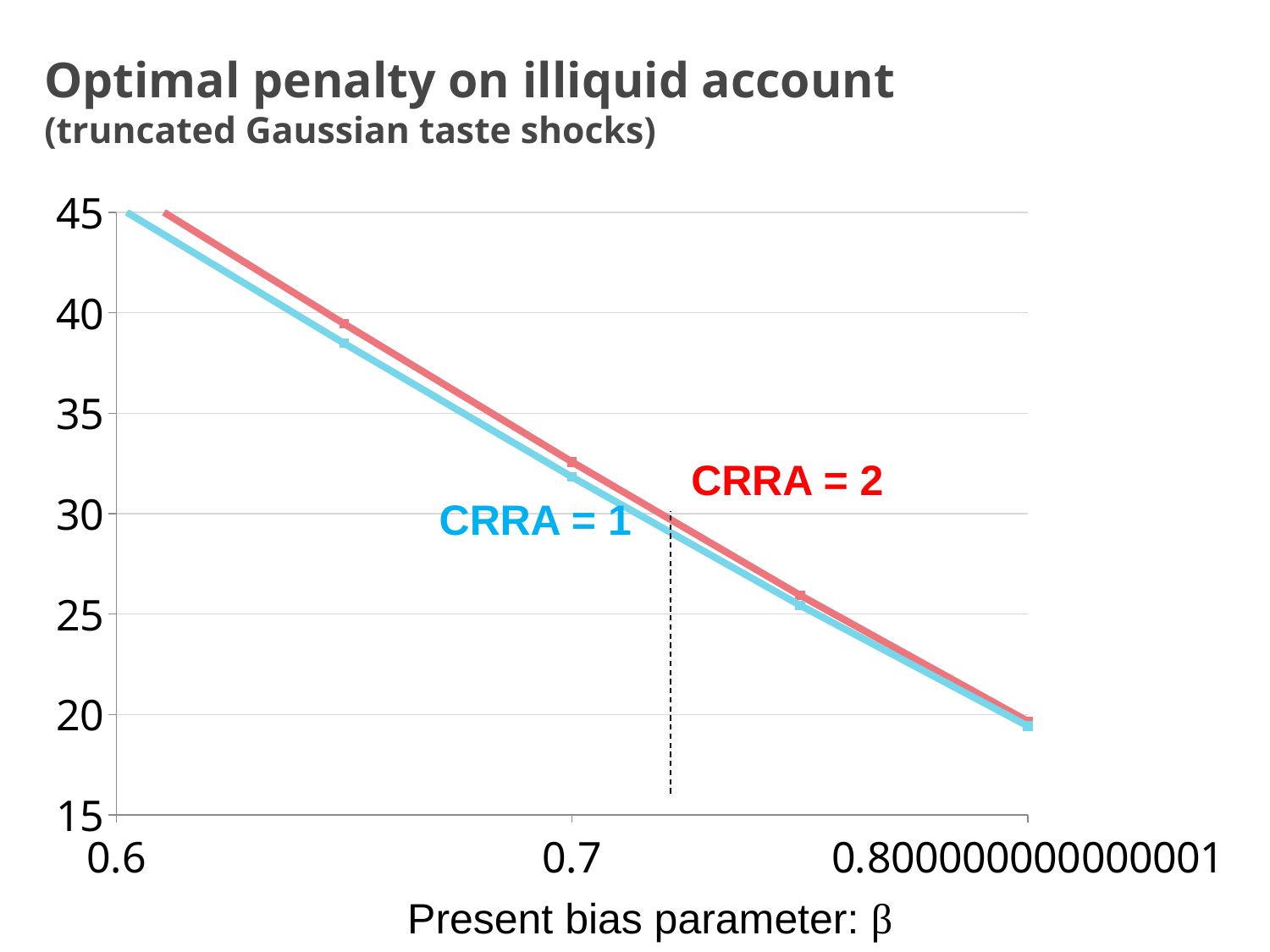
Is the value for CRRA = 2 at β = 0.6 greater or less than 40? greater Is the value for CRRA = 2 at β = 0.7 greater or less than 30? greater Is the value for CRRA = 2 at β = 0.8 greater or less than 25? less What is the label of the x axis? Present bias parameter: β Do the values rise or fall as the present bias parameter β increases along the x axis? fall At β = 0.7, which series has the higher value, CRRA = 1 or CRRA = 2? CRRA = 2 What kind of chart is shown on the slide? line chart How many series are plotted on the chart? 2 What is the title of the chart? Optimal penalty on illiquid account (truncated Gaussian taste shocks)